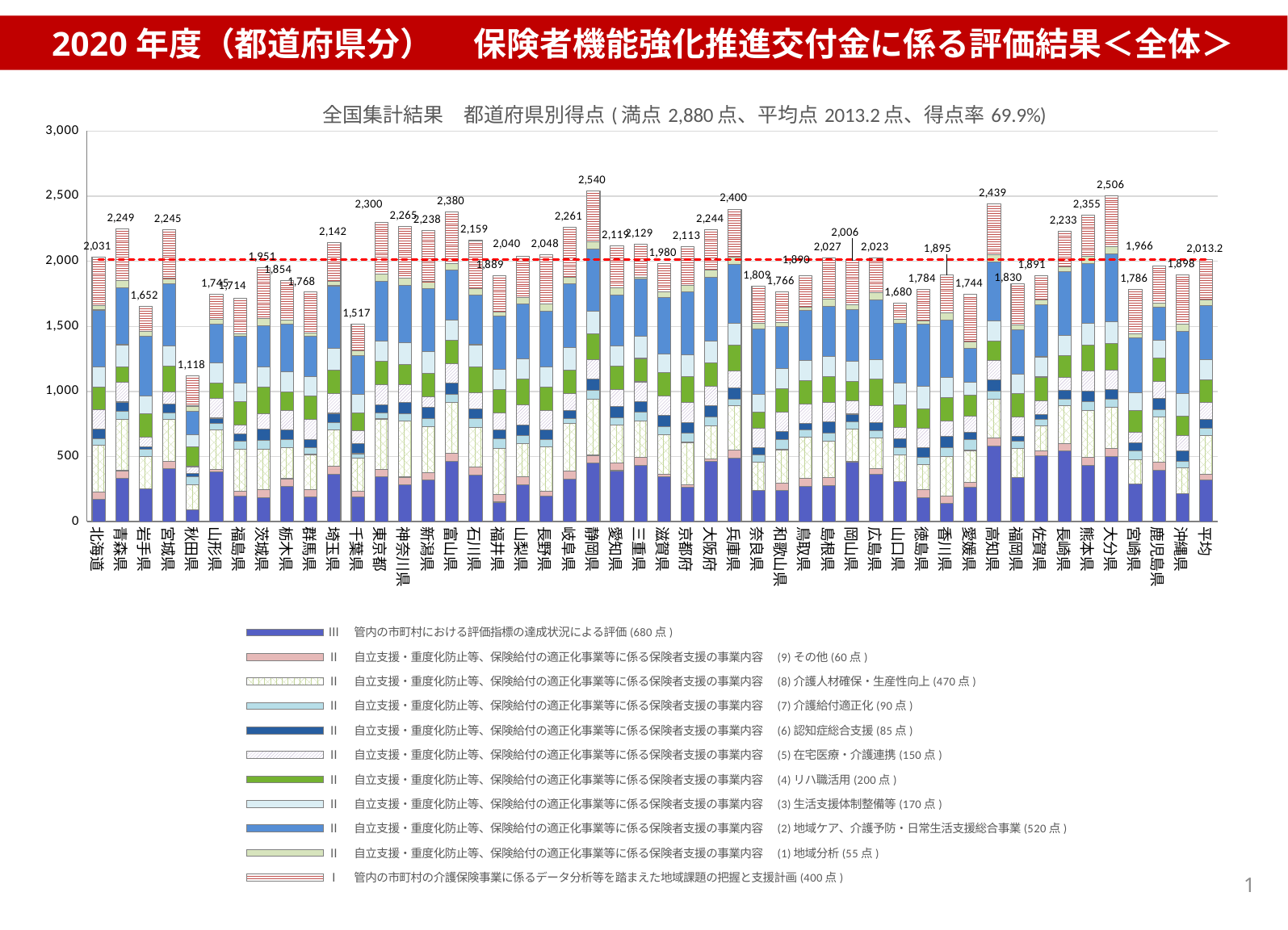
What is the total score shown for 秋田県? 1,118 What is the difference between the total scores of 静岡県 and 秋田県? 1,422 What is the difference between the total scores of 東京都 and 神奈川県? 35 What is the total score shown for 兵庫県? 2,400 What kind of chart is shown on the slide? Stacked bar chart How many series does the legend list? 11 What value is labeled for 平均 (the average bar) at the right end of the chart? 2,013.2 Is the total score for 千葉県 greater or less than 2,000? less Which prefecture has the lowest total score in the chart? 秋田県 What is the total score shown for 静岡県? 2,540 Which prefecture has the highest total score in the chart? 静岡県 Which has a higher total score, 大分県 or 高知県? 大分県